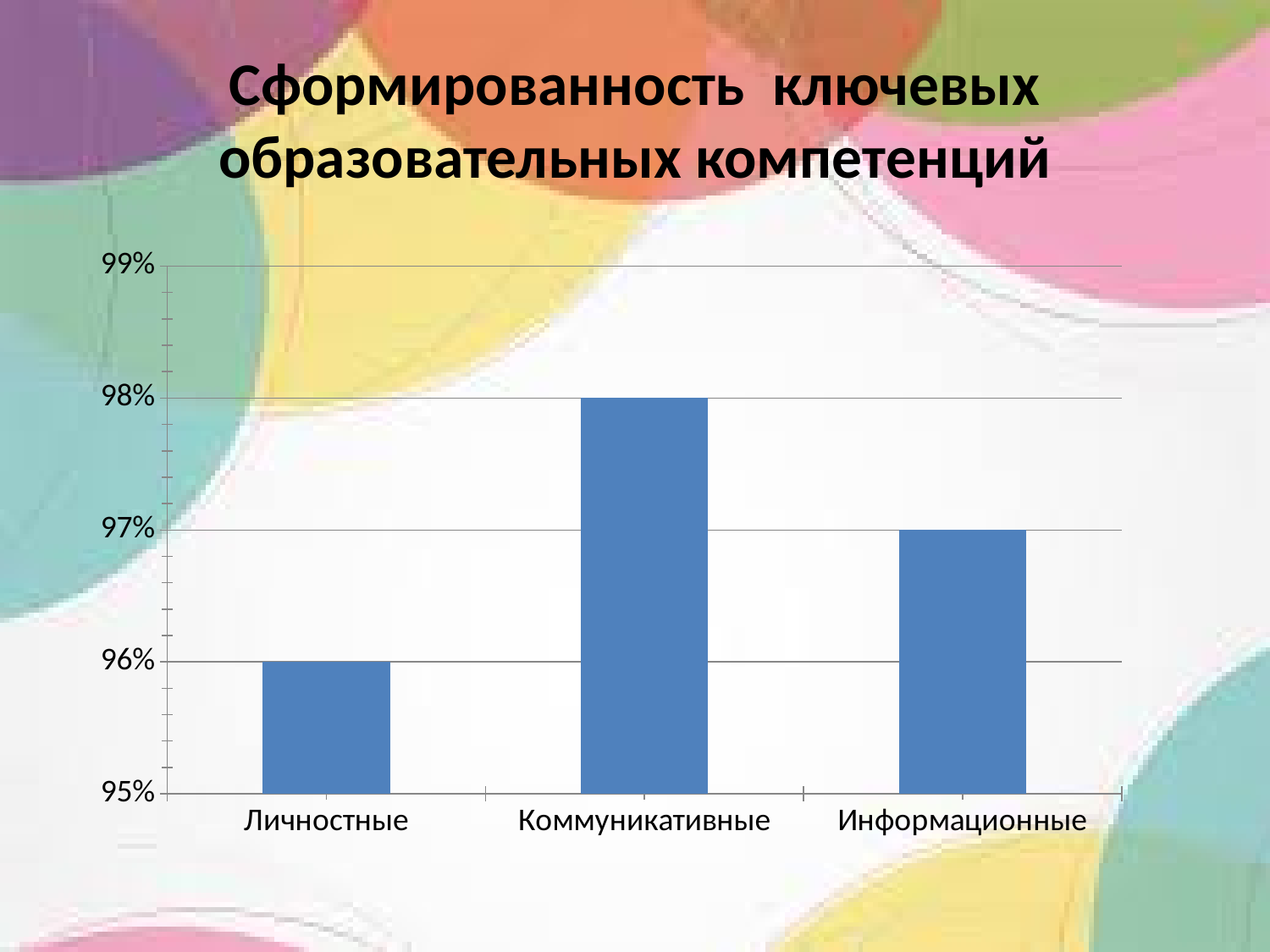
Is the value for Коммуникативные greater or less than 97%? greater What kind of chart is shown on the slide? bar chart What is the value for Информационные? 97% What is the title of the slide? Сформированность ключевых образовательных компетенций What is the value for Личностные? 96% Which category has the highest value? Коммуникативные Which is larger, the value for Информационные or the value for Личностные? Информационные What is the difference between the values for Информационные and Личностные? 1% What is the difference between the values for Коммуникативные and Личностные? 2% How many categories are shown on the chart? 3 Which category has the lowest value? Личностные What is the value for Коммуникативные? 98%